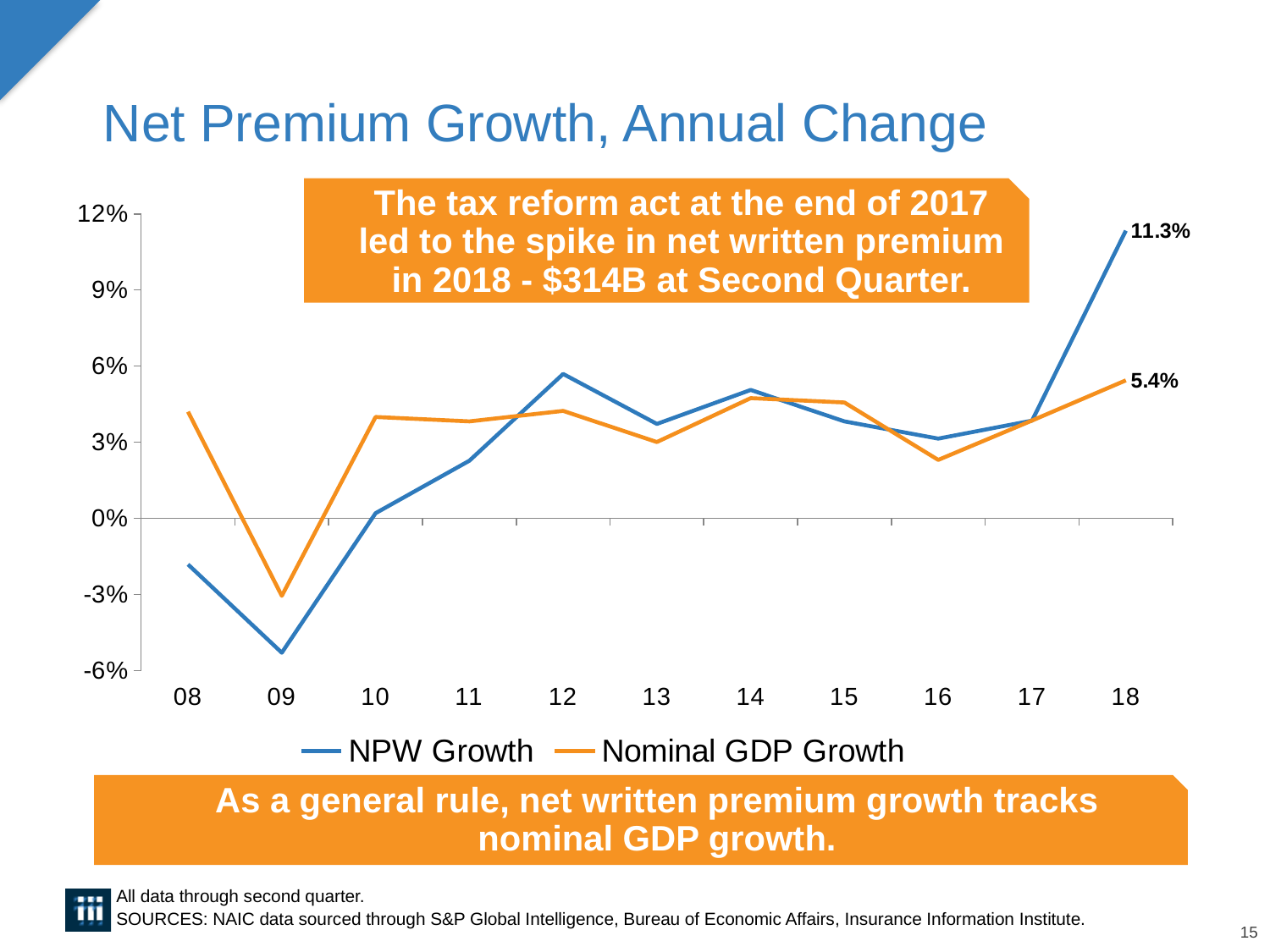
How many series does the legend list? 2 What is the Nominal GDP Growth value for 18? 5.4% Is the Nominal GDP Growth value for 08 greater or less than 3%? greater In which year is NPW Growth at its highest? 18 In 18, which series has the larger value, NPW Growth or Nominal GDP Growth? NPW Growth How many years are plotted along the x axis? 11 What is the title of the chart? Net Premium Growth, Annual Change What kind of chart is shown on the slide? Line chart What is the difference between NPW Growth and Nominal GDP Growth in 18? 5.9 percentage points Is the NPW Growth value for 09 greater or less than -3%? less What is the NPW Growth value for 18? 11.3% In which year is NPW Growth at its lowest? 09